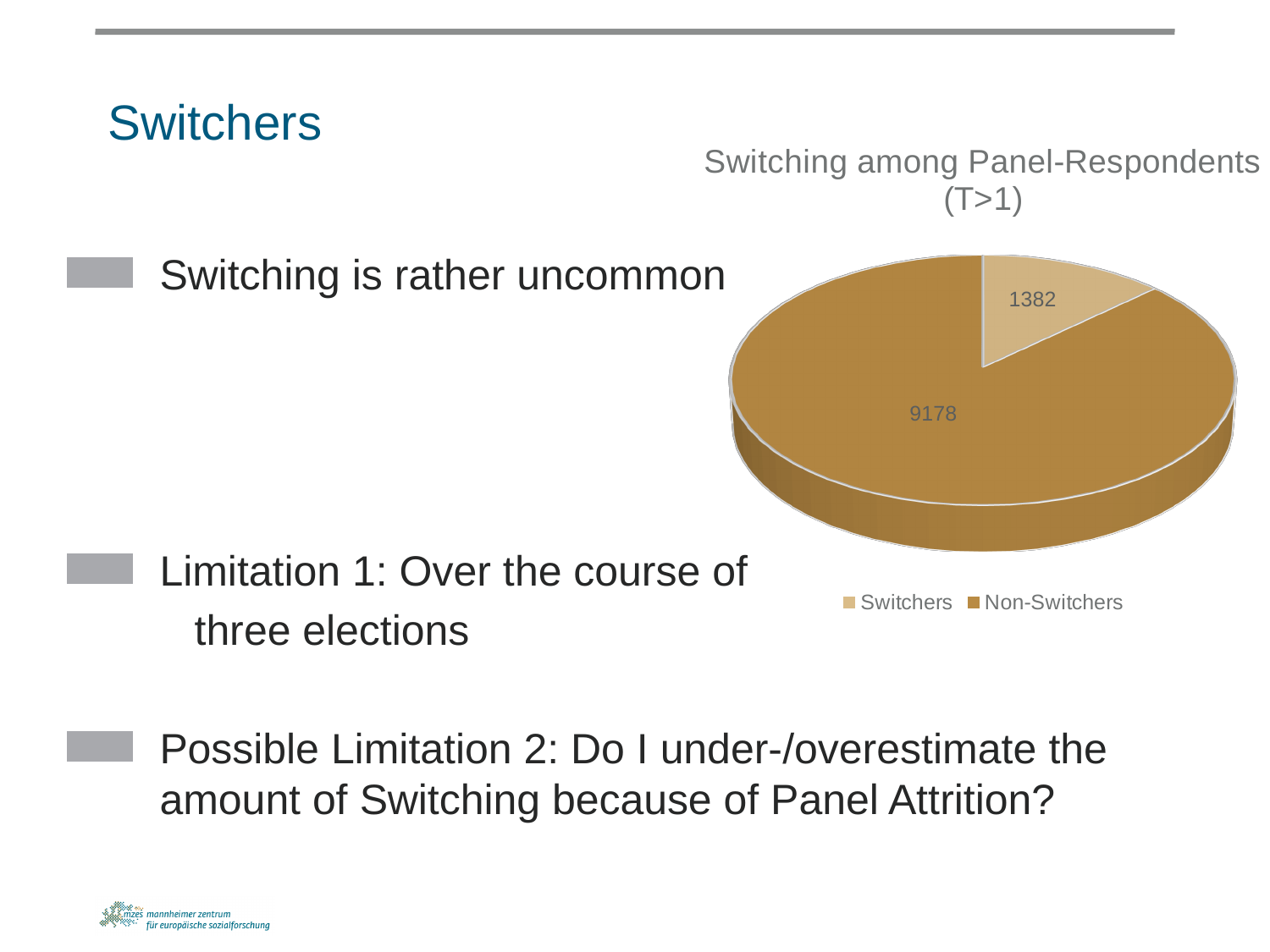
How many slices does the pie chart have? 2 What kind of chart is shown on the slide? Pie chart What is the value for Switchers? 1382 How many series does the legend list? 2 What is the total of the two slices in the pie chart? 10560 What is the value for Non-Switchers? 9178 Which is larger, the value for Switchers or the value for Non-Switchers? Non-Switchers Which category has the largest slice? Non-Switchers Which category has the smallest slice? Switchers What share of the pie do Switchers represent? 13.1% What is the difference between the Non-Switchers and Switchers values? 7796 What is the title of the chart? Switching among Panel-Respondents (T>1)